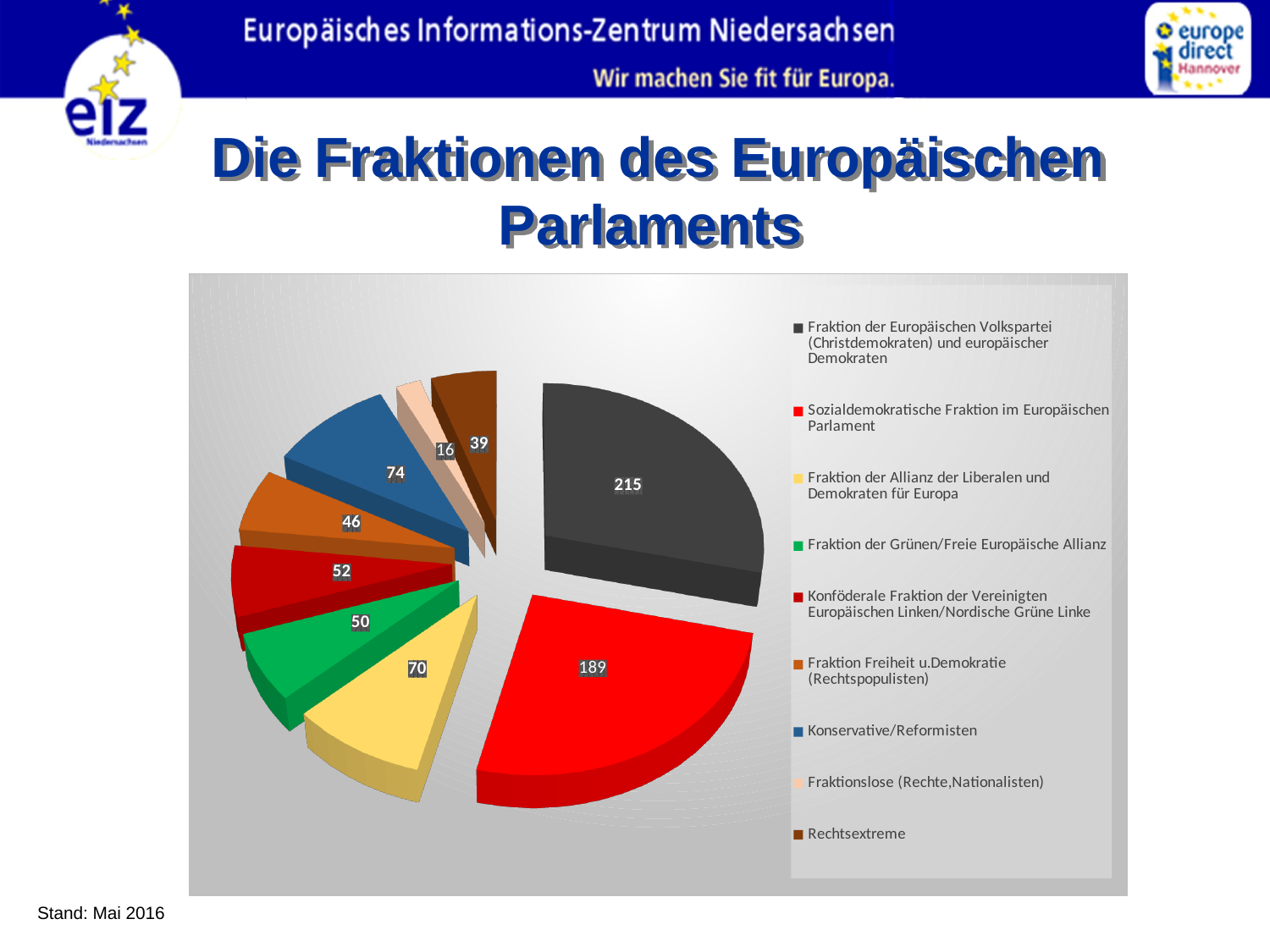
What is the title of the slide containing the pie chart? Die Fraktionen des Europäischen Parlaments What is the value for Konservative/Reformisten? 74 Which group has the largest slice in the pie chart? Fraktion der Europäischen Volkspartei (Christdemokraten) und europäischer Demokraten What is the difference between the values for the Fraktion der Europäischen Volkspartei and the Sozialdemokratische Fraktion? 26 What is the value for Rechtsextreme? 39 How many entries does the legend of the pie chart list? 9 What is the value for the Fraktion der Europäischen Volkspartei (Christdemokraten) und europäischer Demokraten? 215 Which is larger: the value for Fraktion der Grünen/Freie Europäische Allianz or the value for Konföderale Fraktion der Vereinigten Europäischen Linken/Nordische Grüne Linke? Konföderale Fraktion der Vereinigten Europäischen Linken/Nordische Grüne Linke Which group has the smallest slice in the pie chart? Fraktionslose (Rechte,Nationalisten) How many slices does the pie chart have? 9 What kind of chart is shown on the slide? pie chart What is the value for the Sozialdemokratische Fraktion im Europäischen Parlament? 189